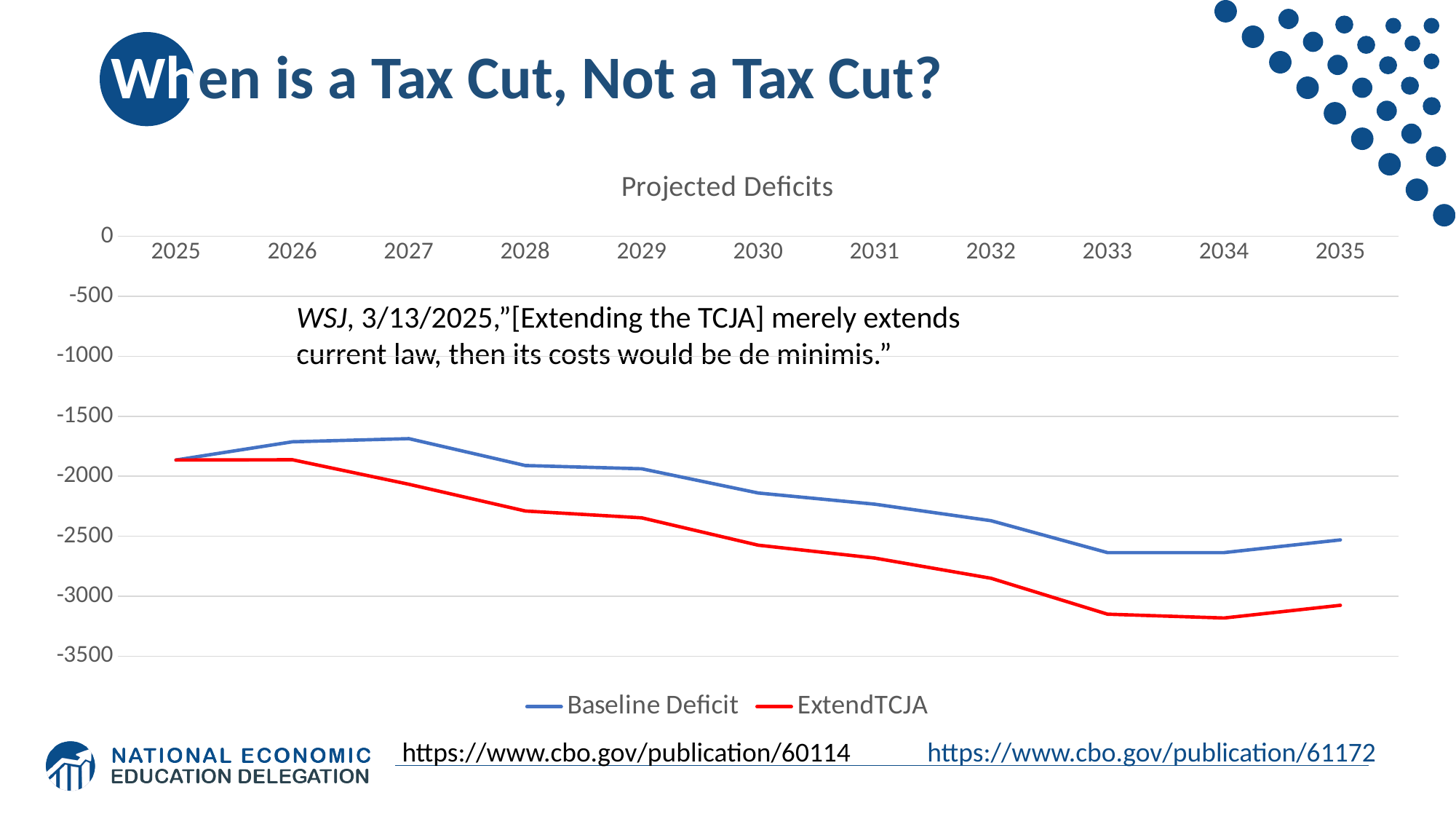
What is the title of the chart? Projected Deficits Which series is drawn in red? ExtendTCJA Is the value for Baseline Deficit in 2030 greater or less than -2000? less Does the ExtendTCJA line rise or fall from 2026 to 2034? fall Is the value for ExtendTCJA in 2028 greater or less than -2500? greater How many years are shown on the x axis? 11 In 2030, which series has the higher (less negative) value, Baseline Deficit or ExtendTCJA? Baseline Deficit What kind of chart is shown on the slide? line chart Is the value for ExtendTCJA in 2033 greater or less than -3000? less Does the Baseline Deficit line rise or fall from 2027 to 2033? fall How many series does the legend list? 2